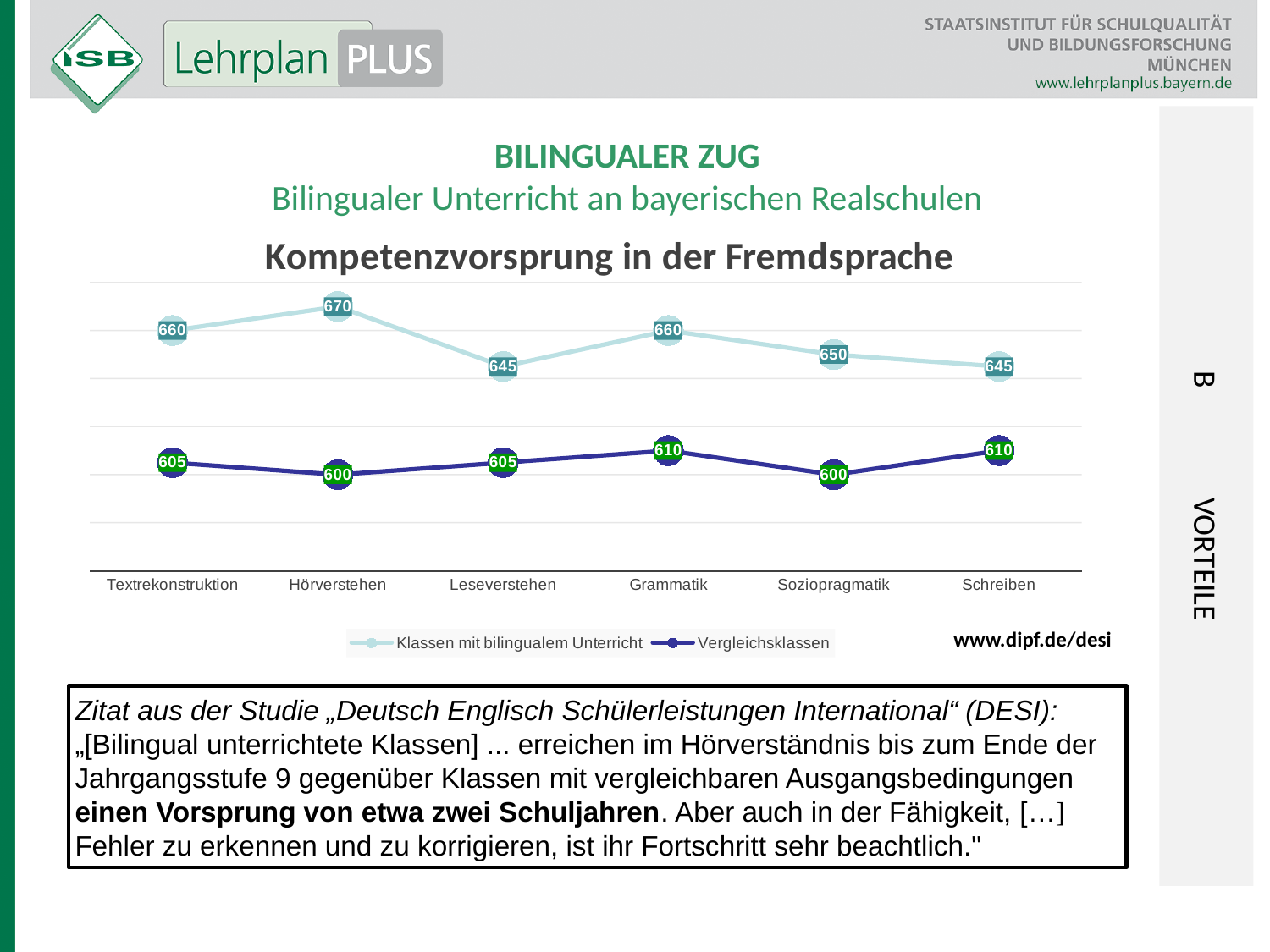
How many series does the legend list? 2 Which series has the larger value for Grammatik? Klassen mit bilingualem Unterricht What kind of chart is shown on the slide? Line chart What is the value for Schreiben in the series 'Klassen mit bilingualem Unterricht'? 645 What is the value for Hörverstehen in the series 'Klassen mit bilingualem Unterricht'? 670 What is the title of the chart? Kompetenzvorsprung in der Fremdsprache Which category has the highest value for 'Klassen mit bilingualem Unterricht'? Hörverstehen Which category has the lowest value for 'Klassen mit bilingualem Unterricht'? Leseverstehen and Schreiben (both 645) What is the difference between the two series for Schreiben? 35 How many categories are shown on the x axis? 6 What is the difference between the two series for Hörverstehen? 70